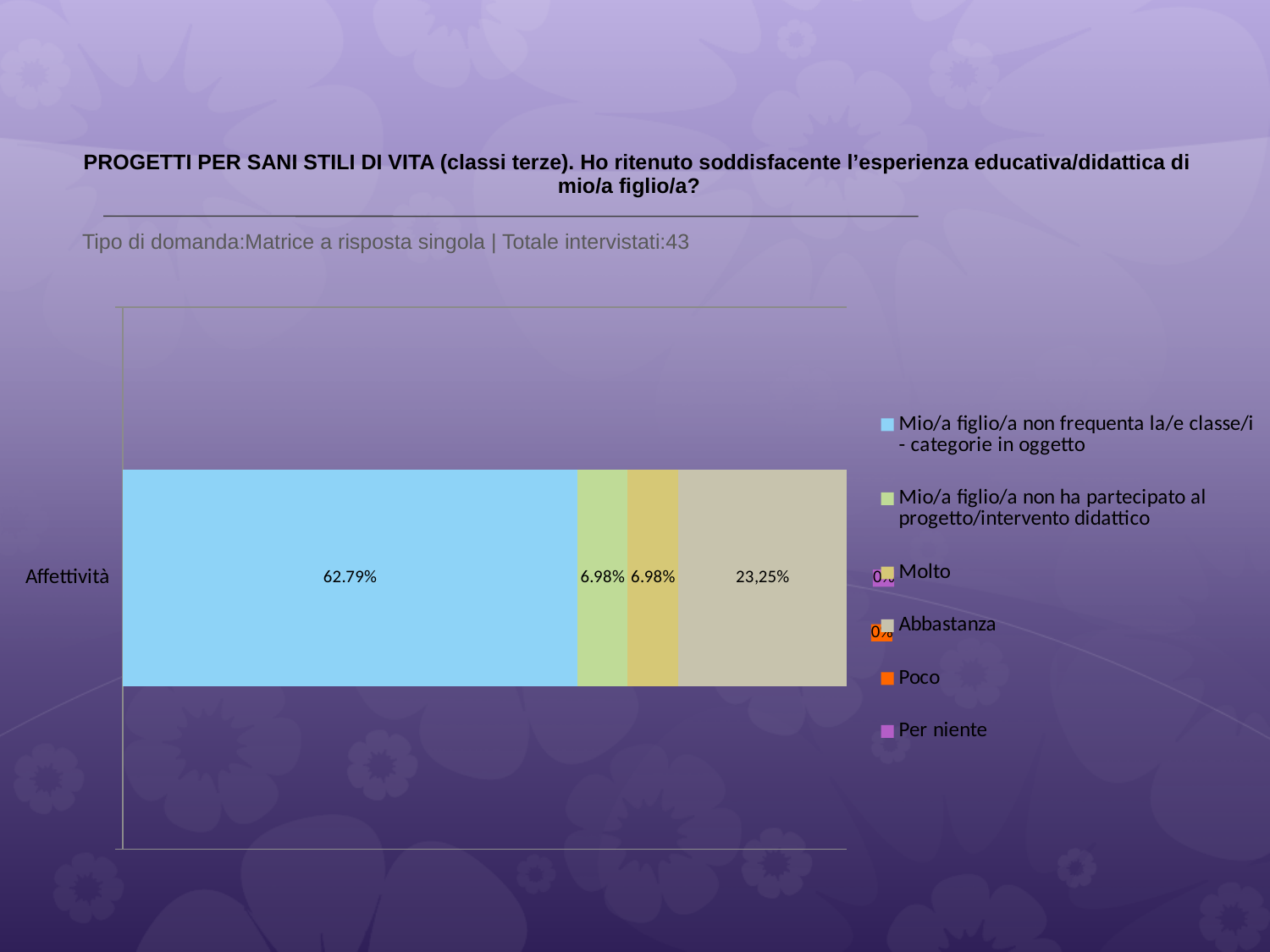
What is the value for 'Poco' in the Affettività bar? 0% How many series does the legend list? 6 Which series has the largest share of the Affettività bar? Mio/a figlio/a non frequenta la/e classe/i - categorie in oggetto What is the value for 'Abbastanza' in the Affettività bar? 23,25% What is the value for 'Mio/a figlio/a non frequenta la/e classe/i - categorie in oggetto' in the Affettività bar? 62.79% What is the label of the single category shown on the chart's axis? Affettività How many categories are plotted on the chart? 1 Which is larger in the Affettività bar: 'Abbastanza' or 'Molto'? Abbastanza What is the value for 'Mio/a figlio/a non ha partecipato al progetto/intervento didattico' in the Affettività bar? 6.98% What is the value for 'Molto' in the Affettività bar? 6.98% What is the difference between the 'Mio/a figlio/a non frequenta la/e classe/i - categorie in oggetto' value and the 'Abbastanza' value? 39.54% What kind of chart is shown on the slide? Stacked bar chart